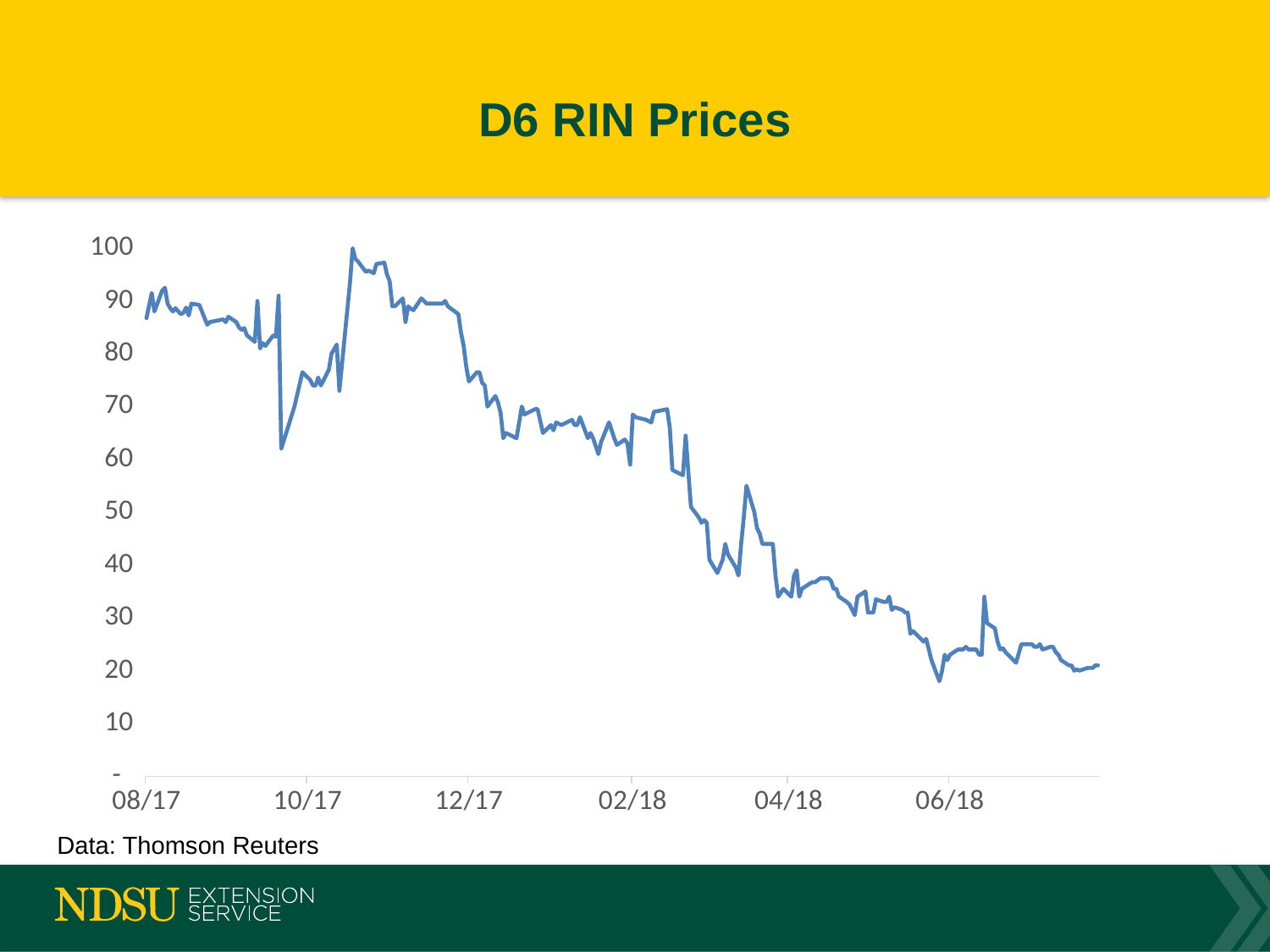
Is the highest D6 RIN price on the chart greater or less than 90? greater Is the D6 RIN price at 08/17 greater or less than 80? greater How many date labels are shown on the x axis? 6 Is the D6 RIN price at 06/18 greater or less than 30? less Is the D6 RIN price higher at 08/17 or at 06/18? 08/17 Overall, do D6 RIN prices rise or fall from 08/17 to the end of the series? fall What data source is cited below the chart? Thomson Reuters What is the title of the chart? D6 RIN Prices What kind of chart is shown on the slide? line chart